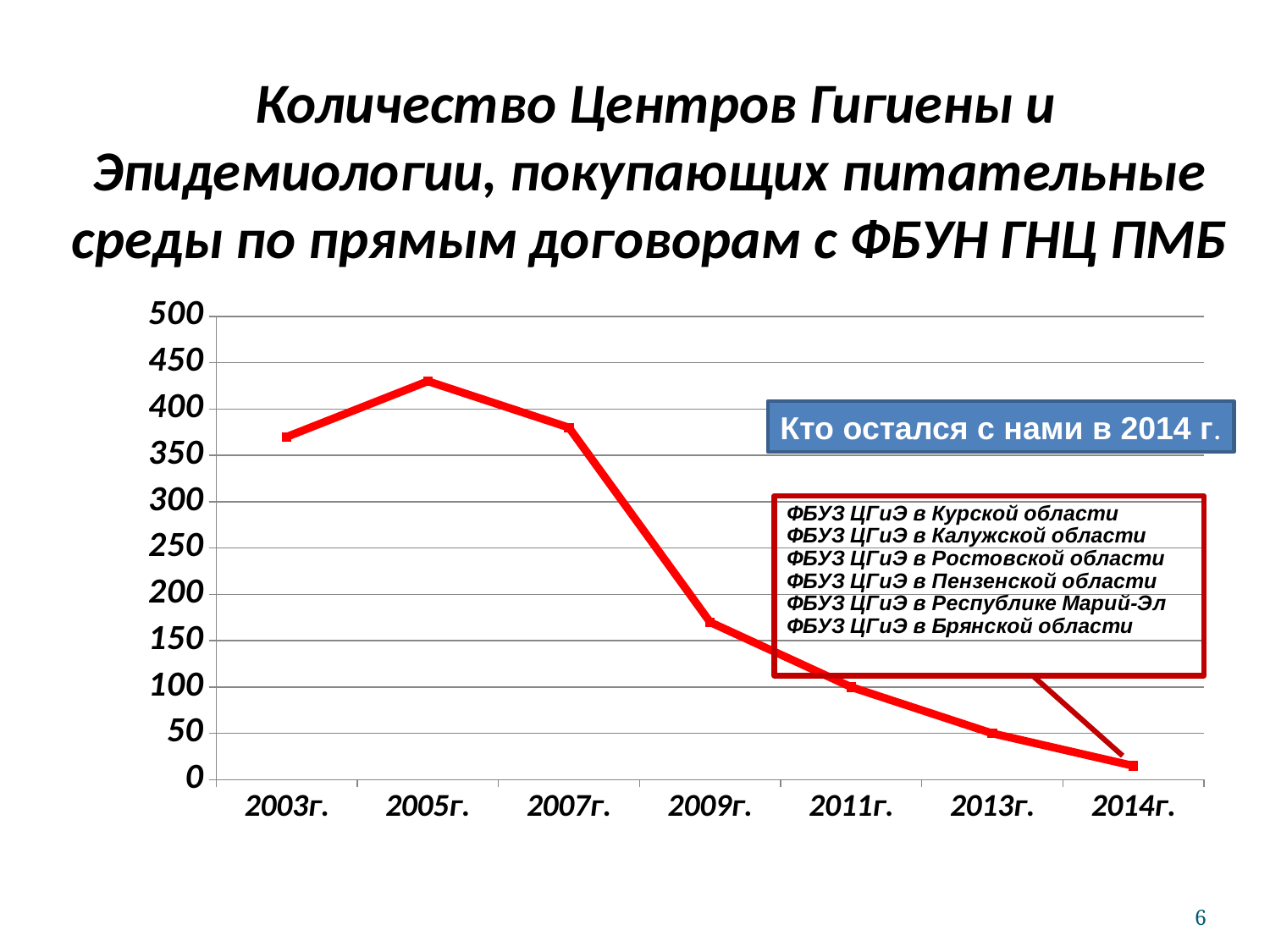
Do the values rise or fall from 2007г. to 2014г.? fall Is the value for 2003г. greater or less than 350? greater Which year has the lowest value on the chart? 2014г. Is the value for 2014г. greater or less than 50? less How many years are plotted along the x axis of the chart? 7 Is the value for 2005г. greater or less than 400? greater Which year has the highest value on the chart? 2005г. Which is larger, the value for 2007г. or the value for 2009г.? 2007г. What kind of chart is shown on the slide? line chart What colour is the line plotted on the chart? red